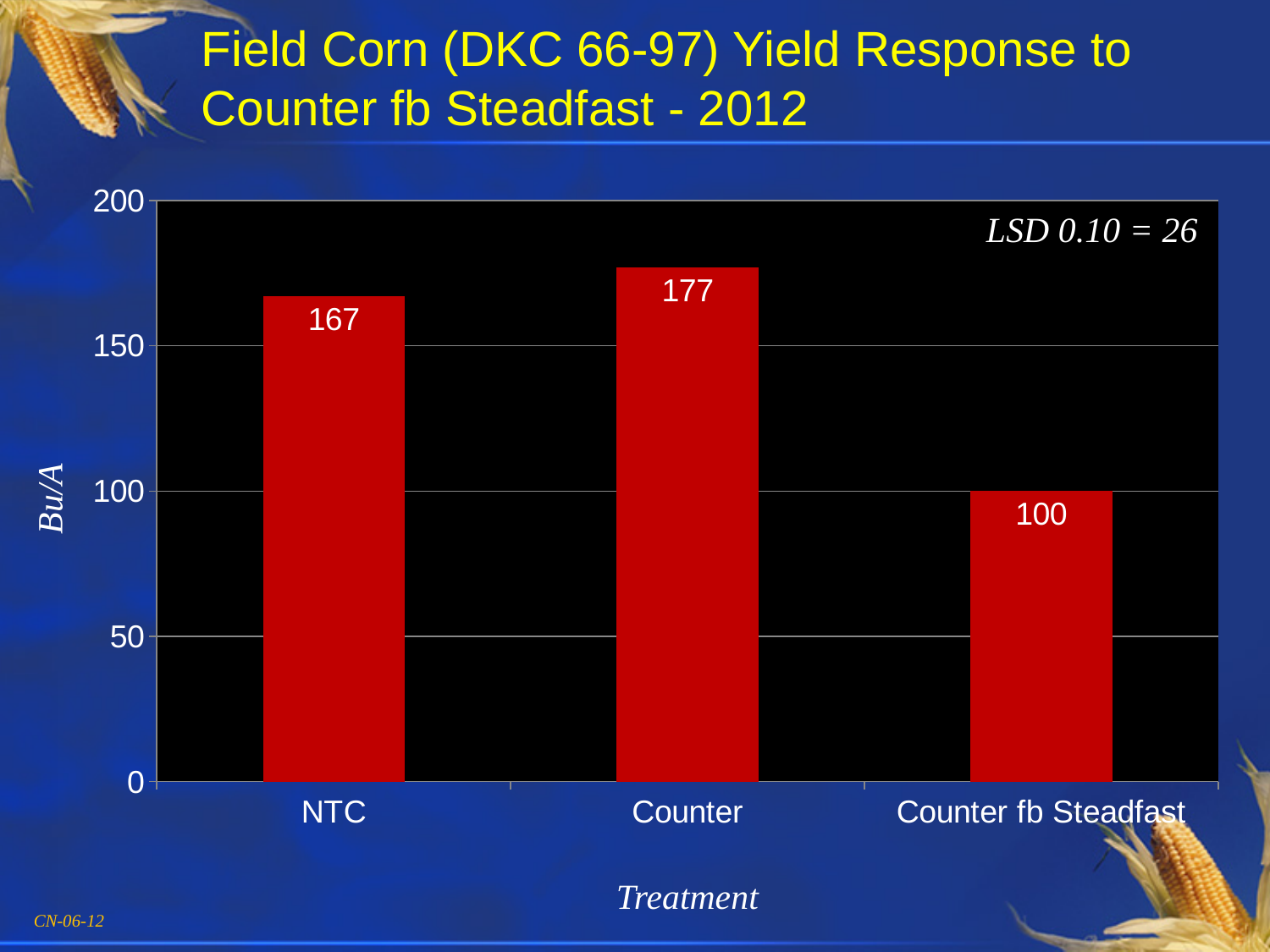
What is the yield value for Counter fb Steadfast? 100 How many treatments are shown on the chart? 3 Which treatment has the highest yield? Counter What is the yield value for Counter? 177 Which has a larger yield, NTC or Counter fb Steadfast? NTC Which treatment has the lowest yield? Counter fb Steadfast What is the difference in yield between NTC and Counter fb Steadfast? 67 Is the value for Counter greater or less than 150? greater What is the label of the y axis? Bu/A What is the difference in yield between Counter and NTC? 10 What is the yield value for NTC? 167 What kind of chart is shown on the slide? bar chart